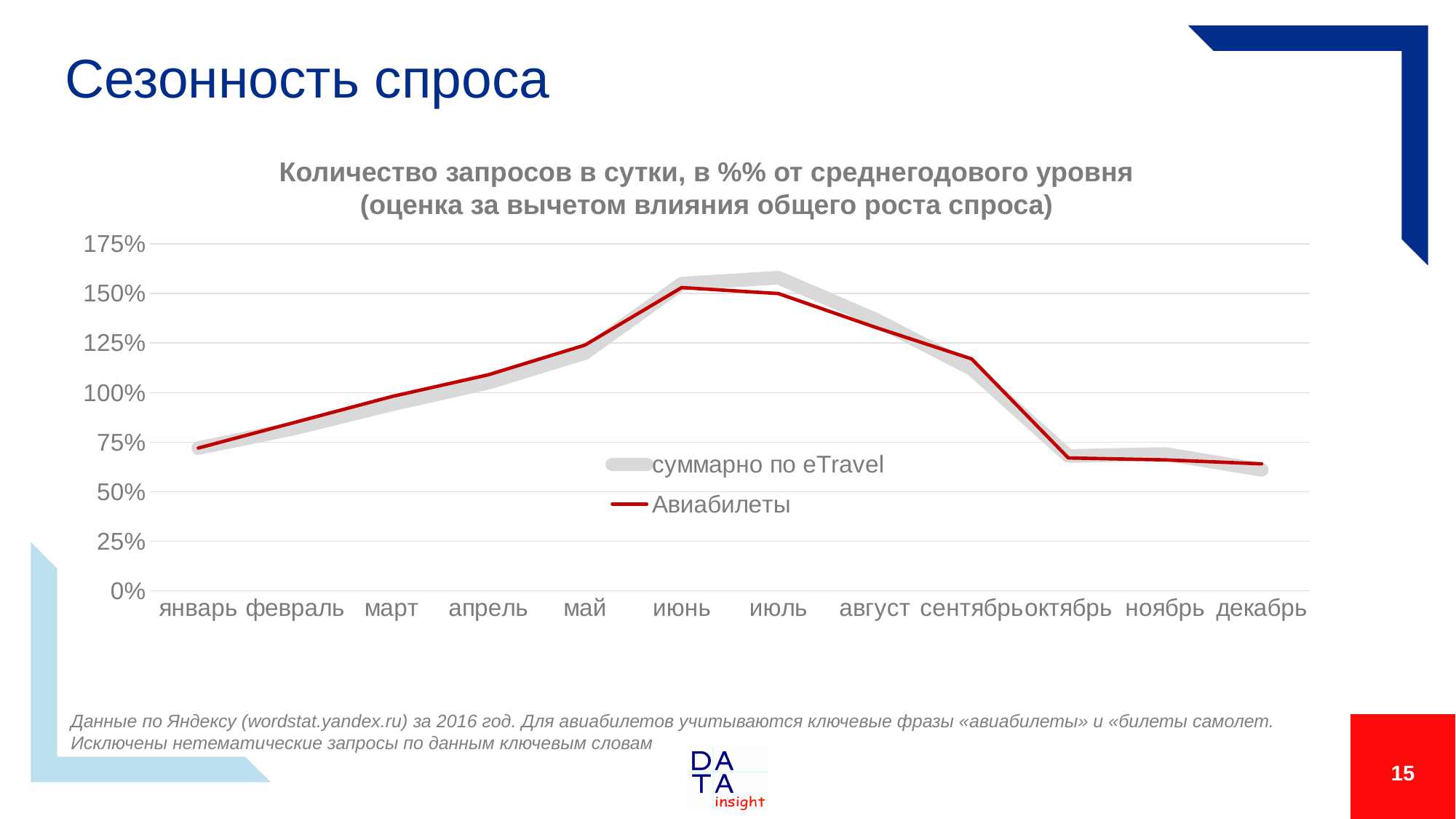
How many months are shown along the x axis? 12 Is the value for Авиабилеты in январь greater or less than 100%? less Does the Авиабилеты series rise or fall from июль to октябрь? fall How many series does the legend list? 2 Does the Авиабилеты series rise or fall from январь to июнь? rise In which month does the Авиабилеты series reach its highest value? июнь Is the value for Авиабилеты in сентябрь greater or less than 100%? greater Which series is drawn as the thick grey line? суммарно по eTravel What kind of chart is shown on the slide? line chart Which is larger for the Авиабилеты series: the value in июнь or the value in декабрь? июнь Is the value for Авиабилеты in июнь greater or less than 125%? greater